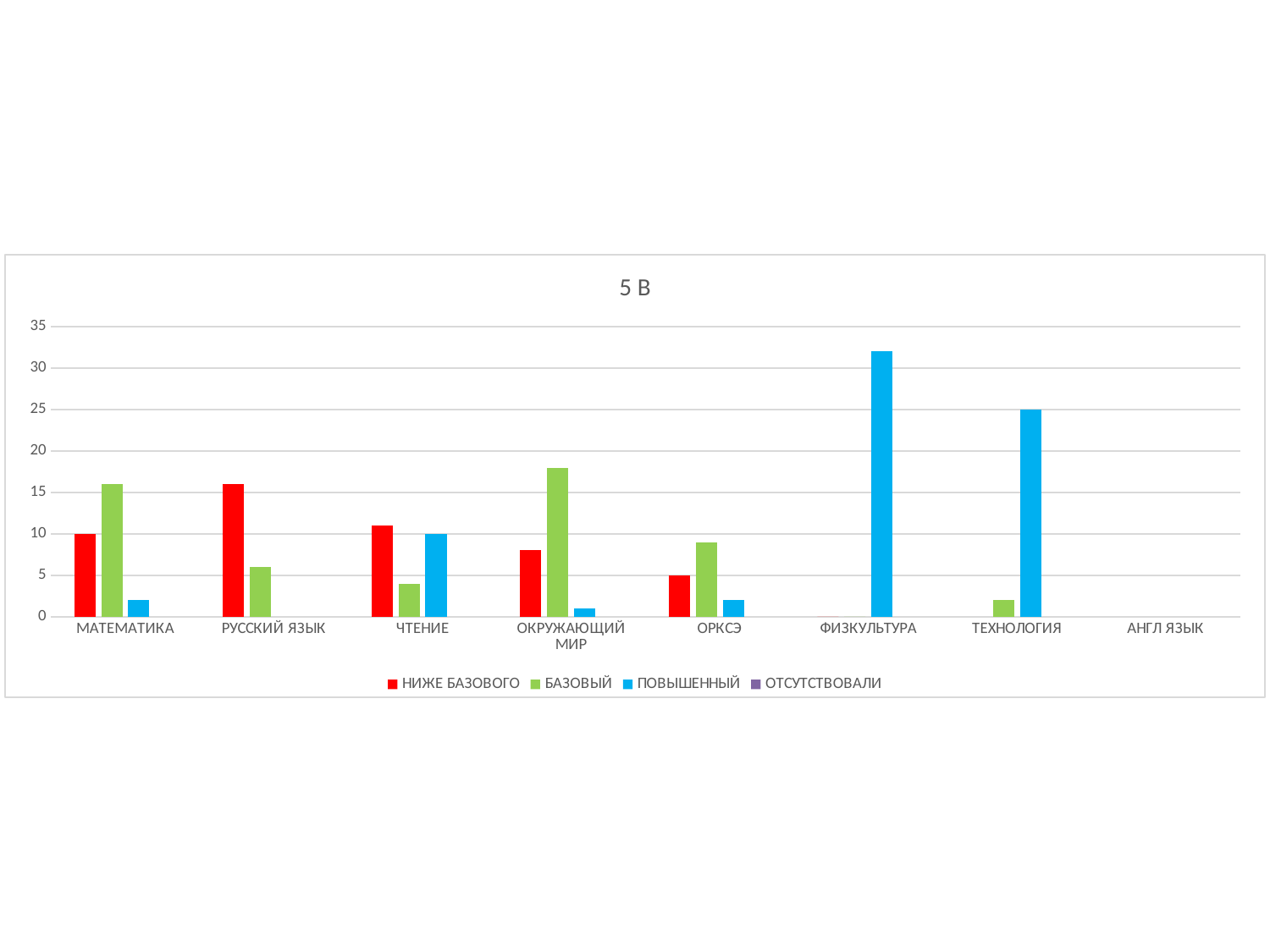
What is the title of the chart? 5 В How many series does the legend list? 4 What kind of chart is shown on the slide? bar chart Which category has the highest ПОВЫШЕННЫЙ value? ФИЗКУЛЬТУРА Is the value of ПОВЫШЕННЫЙ for ФИЗКУЛЬТУРА greater or less than 30? greater What is the value of НИЖЕ БАЗОВОГО for МАТЕМАТИКА? 10 What is the value of ПОВЫШЕННЫЙ for ТЕХНОЛОГИЯ? 25 Which is larger for РУССКИЙ ЯЗЫК: НИЖЕ БАЗОВОГО or БАЗОВЫЙ? НИЖЕ БАЗОВОГО How many categories are shown on the x axis? 8 Which category has the highest БАЗОВЫЙ value? ОКРУЖАЮЩИЙ МИР Is the value of БАЗОВЫЙ for РУССКИЙ ЯЗЫК greater or less than 10? less What is the value of ПОВЫШЕННЫЙ for ЧТЕНИЕ? 10